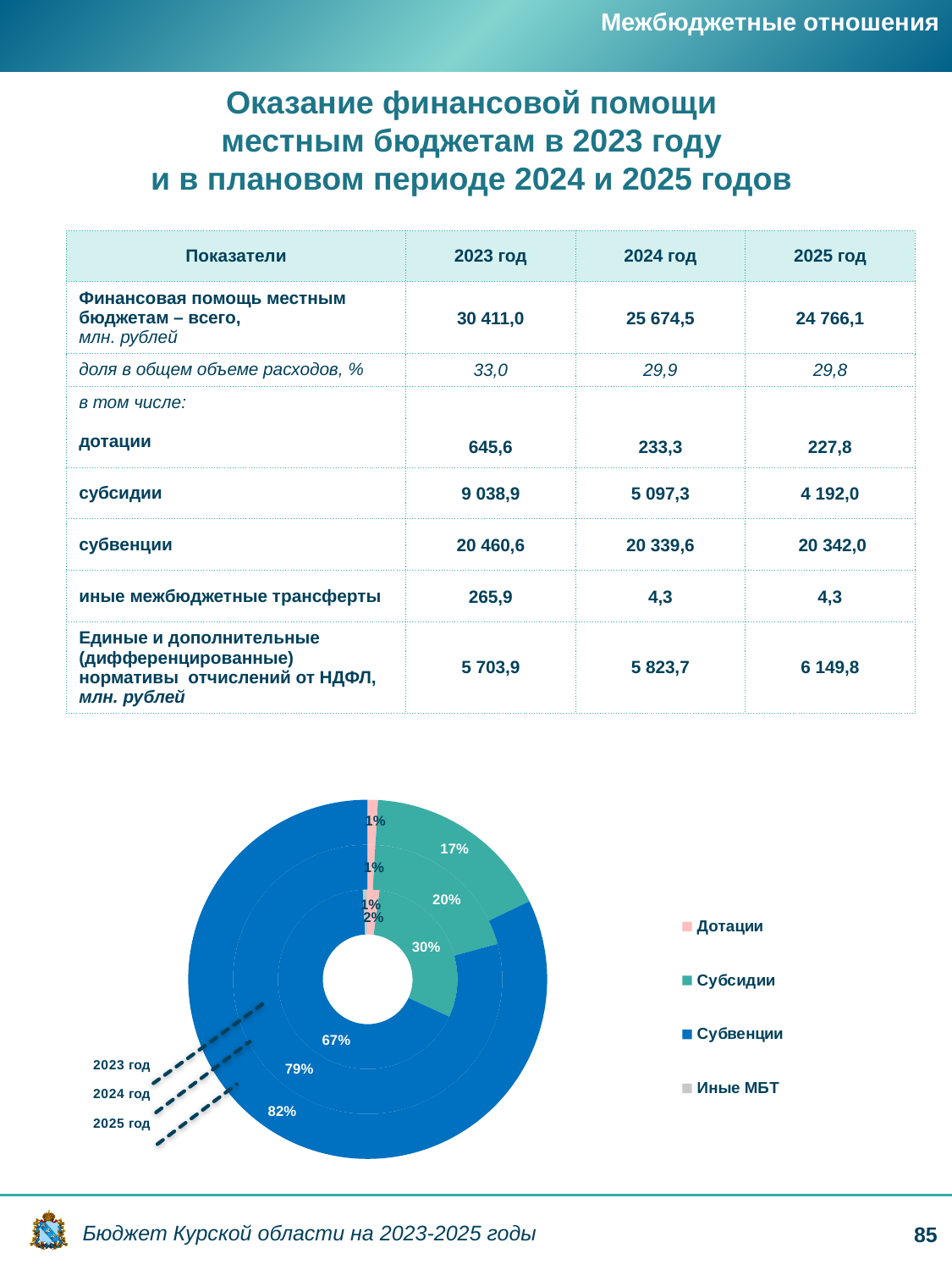
What kind of chart is shown at the bottom of the slide? doughnut (pie) chart In the doughnut chart, which category has the largest share in the 2024 ring? Субвенции In the doughnut chart, what share do Субсидии have in the 2025 ring? 17% How many entries does the legend of the doughnut chart list? 4 In the doughnut chart, what share do Субвенции have in the 2023 ring? 67% In the doughnut chart, which is larger: the Субсидии share in 2023 or the Субсидии share in 2025? 2023 Which legend entry of the doughnut chart is shown in dark blue? Субвенции In the doughnut chart, what share do Дотации have in the 2023 ring? 2% In the doughnut chart, by how many percentage points does the Субвенции share in 2025 exceed the Субвенции share in 2023? 15 In the doughnut chart, does the share of Субвенции rise or fall from the 2023 ring to the 2025 ring? rise